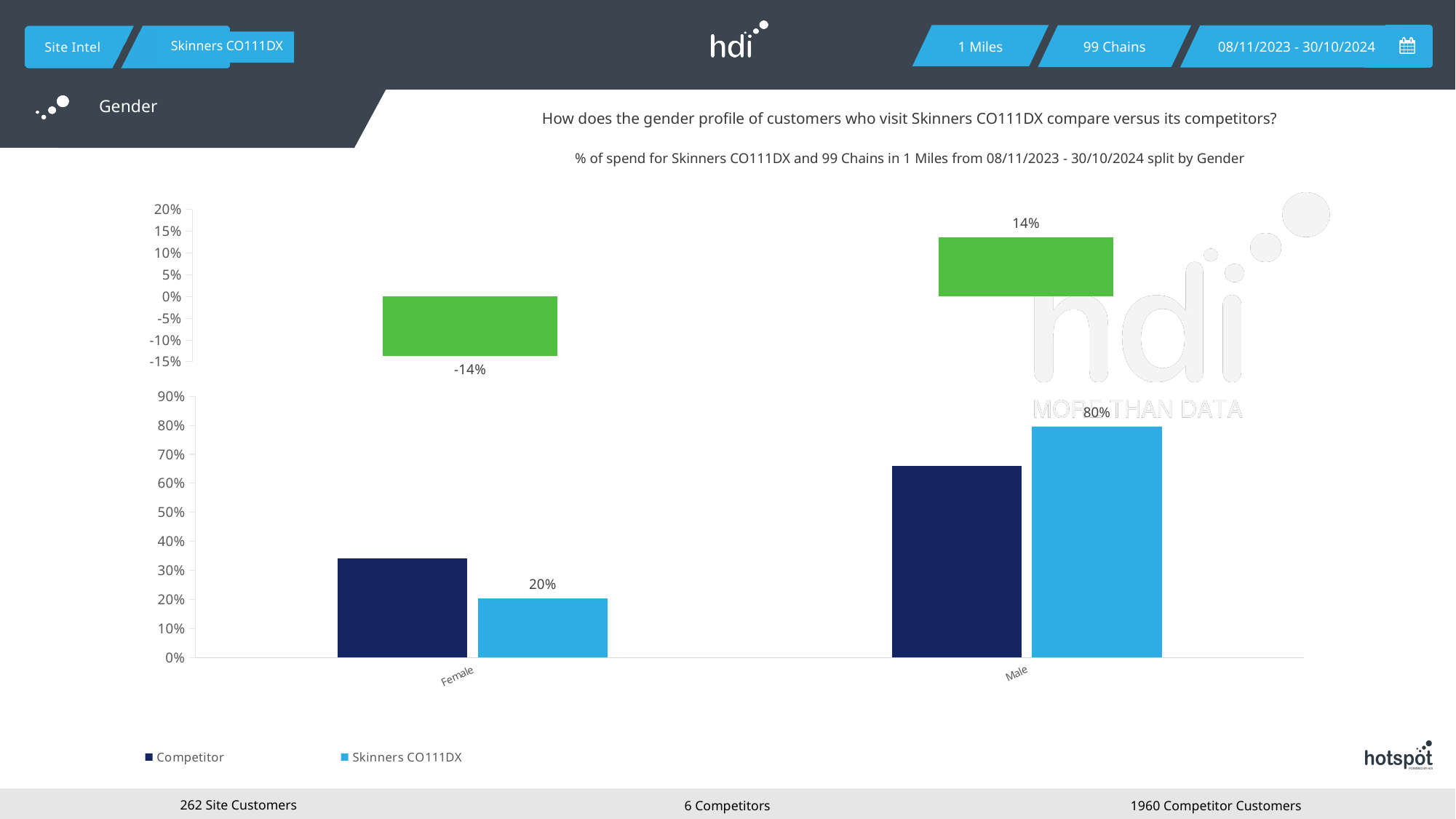
How many categories are shown on the x axis of the bottom chart? 2 In the top chart, what is the value shown for Female? -14% In the bottom chart, which series has the larger value for Male, Competitor or Skinners CO111DX? Skinners CO111DX In the bottom chart, what is the value for Skinners CO111DX for Male? 80% In the bottom chart, is the Competitor value for Male greater or less than 70%? less In the top chart, what is the value shown for Male? 14% In the bottom chart, what is the difference between the Skinners CO111DX values for Male and Female? 60% In the bottom chart, which series has the larger value for Female, Competitor or Skinners CO111DX? Competitor What kind of chart is the bottom chart? Bar chart In the bottom chart, what is the value for Skinners CO111DX for Female? 20% In the bottom chart, is the Competitor value for Female greater or less than 30%? greater How many series does the legend of the bottom chart list? 2